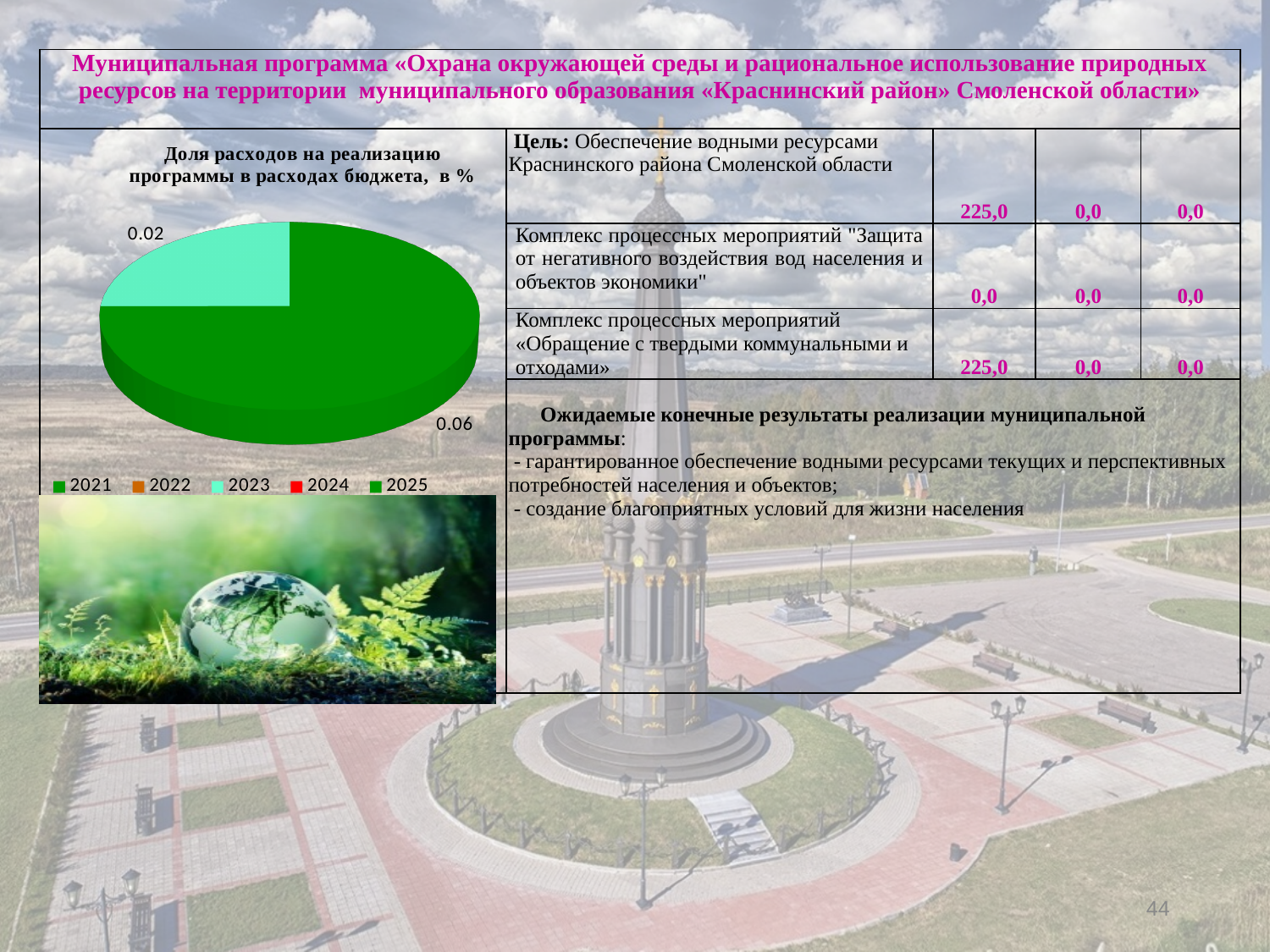
What is the smallest value labelled on the pie chart? 0.02 Which year does the light cyan slice of the pie chart represent, according to the legend? 2023 What is the value for 2023 in the pie chart? 0.02 What is the difference between the two labelled values on the pie chart, 0.06 and 0.02? 0.04 Which years are listed in the legend of the pie chart? 2021, 2022, 2023, 2024, 2025 What value is printed on the large green slice of the pie chart? 0.06 How many entries does the legend of the pie chart list? 5 What is the title of the pie chart on the slide? Доля расходов на реализацию программы в расходах бюджета, в % What is the largest value labelled on the pie chart? 0.06 What value is printed on the light cyan slice of the pie chart? 0.02 What kind of chart is shown on the slide? pie chart How many slices with data labels are visible in the pie chart? 2